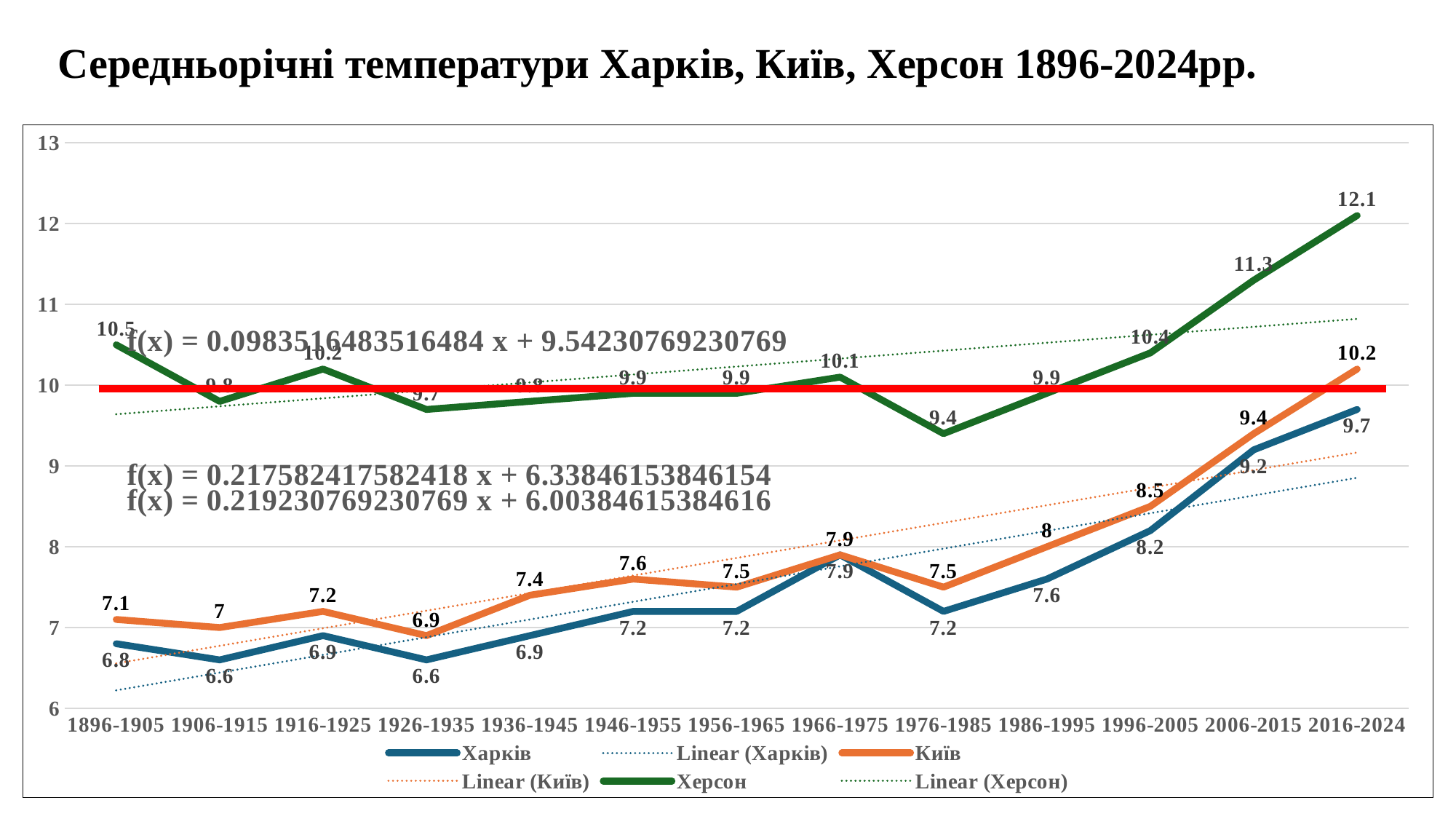
What type of chart is shown on the slide? Line chart How many entries does the legend list? 6 What is the value for Харків in 1896-1905? 6.8 What is the value for Херсон in 2016-2024? 12.1 What is the value for Херсон in 1976-1985? 9.4 How many periods are shown on the x axis? 13 In which period does Херсон reach its highest value? 2016-2024 What is the value for Київ in 2016-2024? 10.2 What is the difference between the Херсон and Київ values in 2016-2024? 1.9 By how much did the Харків value increase from 1896-1905 to 2016-2024? 2.9 Which is larger for Херсон: the value in 1896-1905 or in 2016-2024? 2016-2024 In which period does Київ have its lowest value? 1926-1935